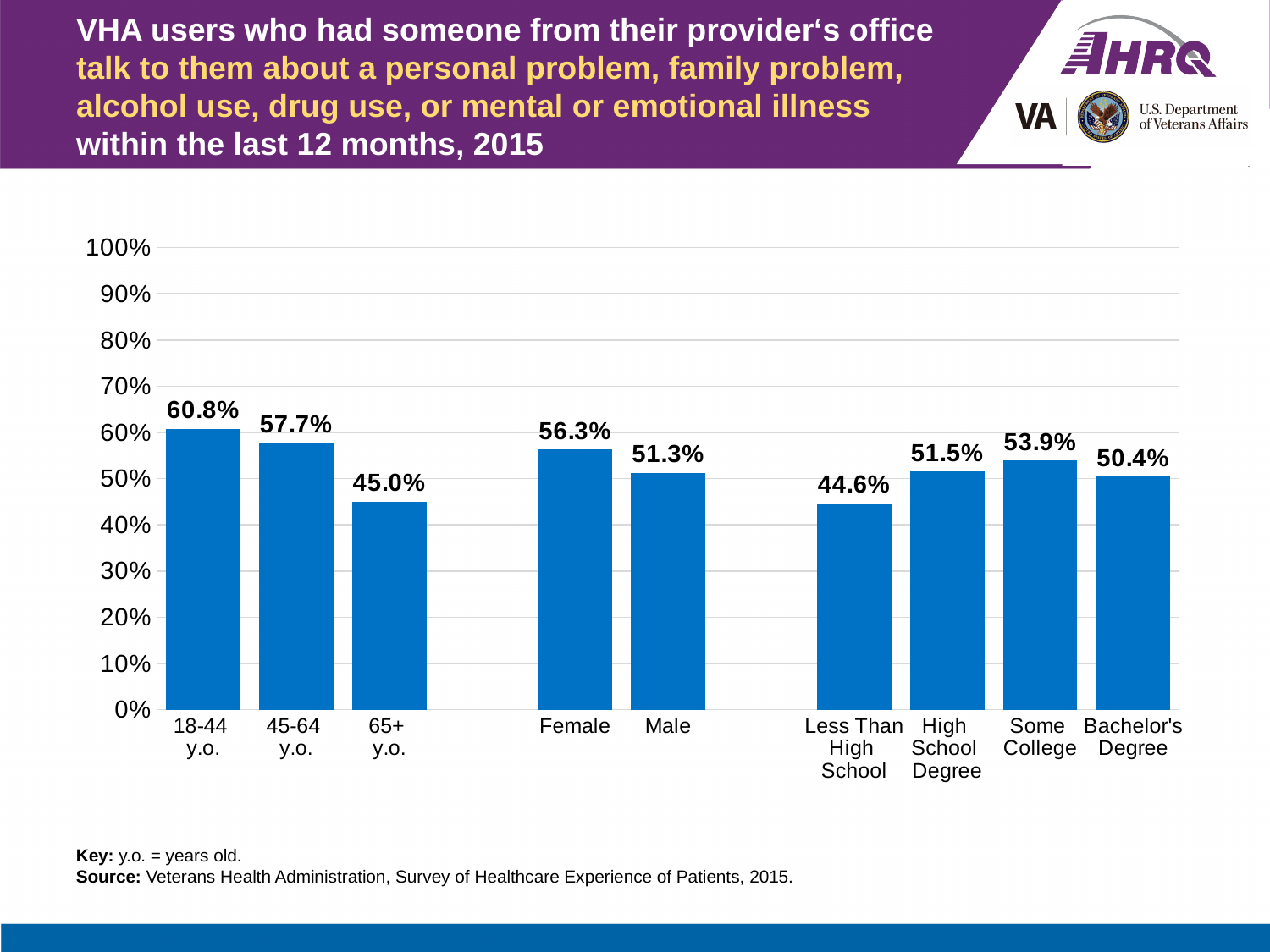
What is the difference between the values for 18-44 y.o. and 65+ y.o.? 15.8% What kind of chart is this? bar chart Is the value for 65+ y.o. greater or less than 50%? less Which is larger, the value for 45-64 y.o. or the value for Bachelor's Degree? 45-64 y.o. What is the value for Some College? 53.9% What is the value for Female? 56.3% Which category has the highest value? 18-44 y.o. Which category has the lowest value? Less Than High School What is the value for Less Than High School? 44.6% How many categories are shown on the x axis? 9 What is the difference between the values for Female and Male? 5.0% What is the value for 18-44 y.o.? 60.8%